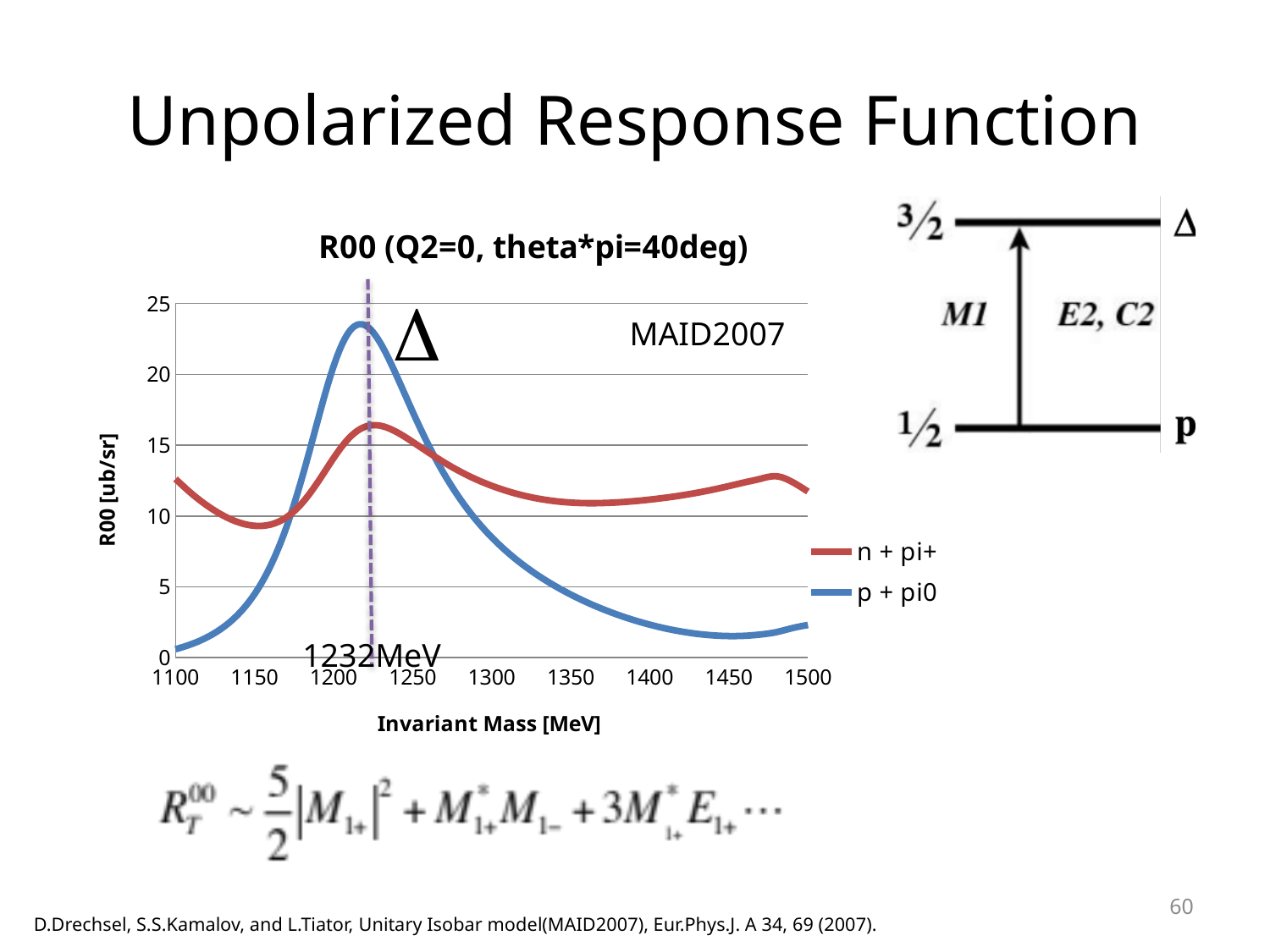
What is the title of the chart? R00 (Q2=0, theta*pi=40deg) What kind of chart is shown on the slide? line chart How many series does the chart legend list? 2 What are the two series named in the chart legend? n + pi+ and p + pi0 Is the value of the n + pi+ curve at 1100 MeV greater or less than 10? greater Is the value of the p + pi0 curve at 1500 MeV greater or less than 5? less Is the peak value of the p + pi0 curve greater or less than 20? greater Which series reaches the highest peak value on the chart? p + pi0 Does the p + pi0 curve rise or fall between 1250 MeV and 1450 MeV? fall At an invariant mass of 1200 MeV, which series has the larger value, n + pi+ or p + pi0? p + pi0 At an invariant mass of 1400 MeV, which series has the larger value, n + pi+ or p + pi0? n + pi+